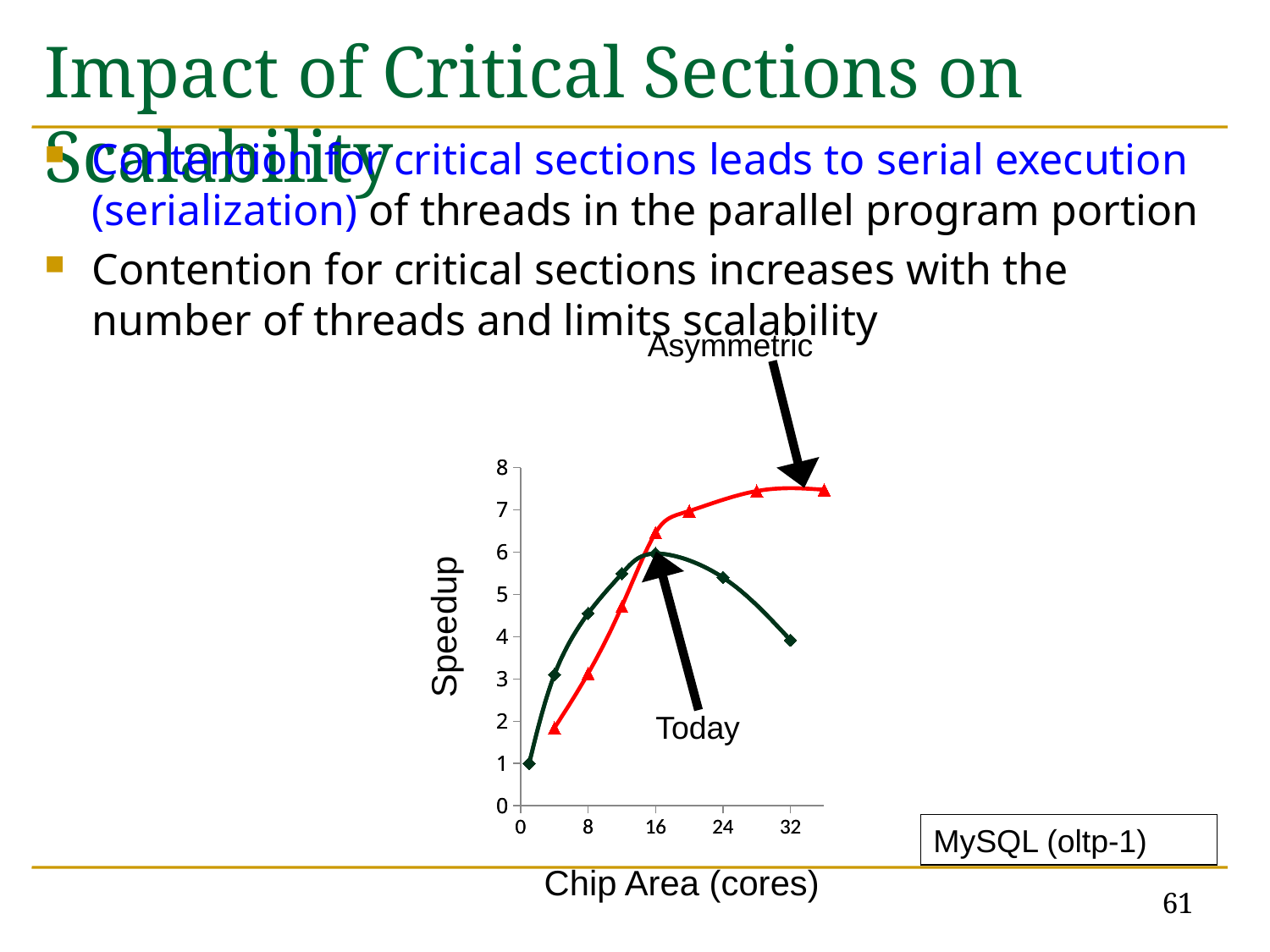
What is the label of the y axis of the chart? Speedup Is the speedup of the green line at 32 cores greater or less than 5? less At 4 cores, which line has the higher speedup, the red line or the green line? the green line Is the speedup of the green line at 8 cores greater or less than 4? greater How many lines (series) are plotted on the chart? 2 Which line is labelled "Asymmetric" on the chart, the red line or the green line? the red line What kind of chart is shown on the slide? line chart At 32 cores, which line has the higher speedup, the red line or the green line? the red line Is the speedup of the red line at 4 cores greater or less than 3? less What is the label of the x axis of the chart? Chip Area (cores) Does the red line rise or fall as chip area increases from 4 to 32 cores? rises